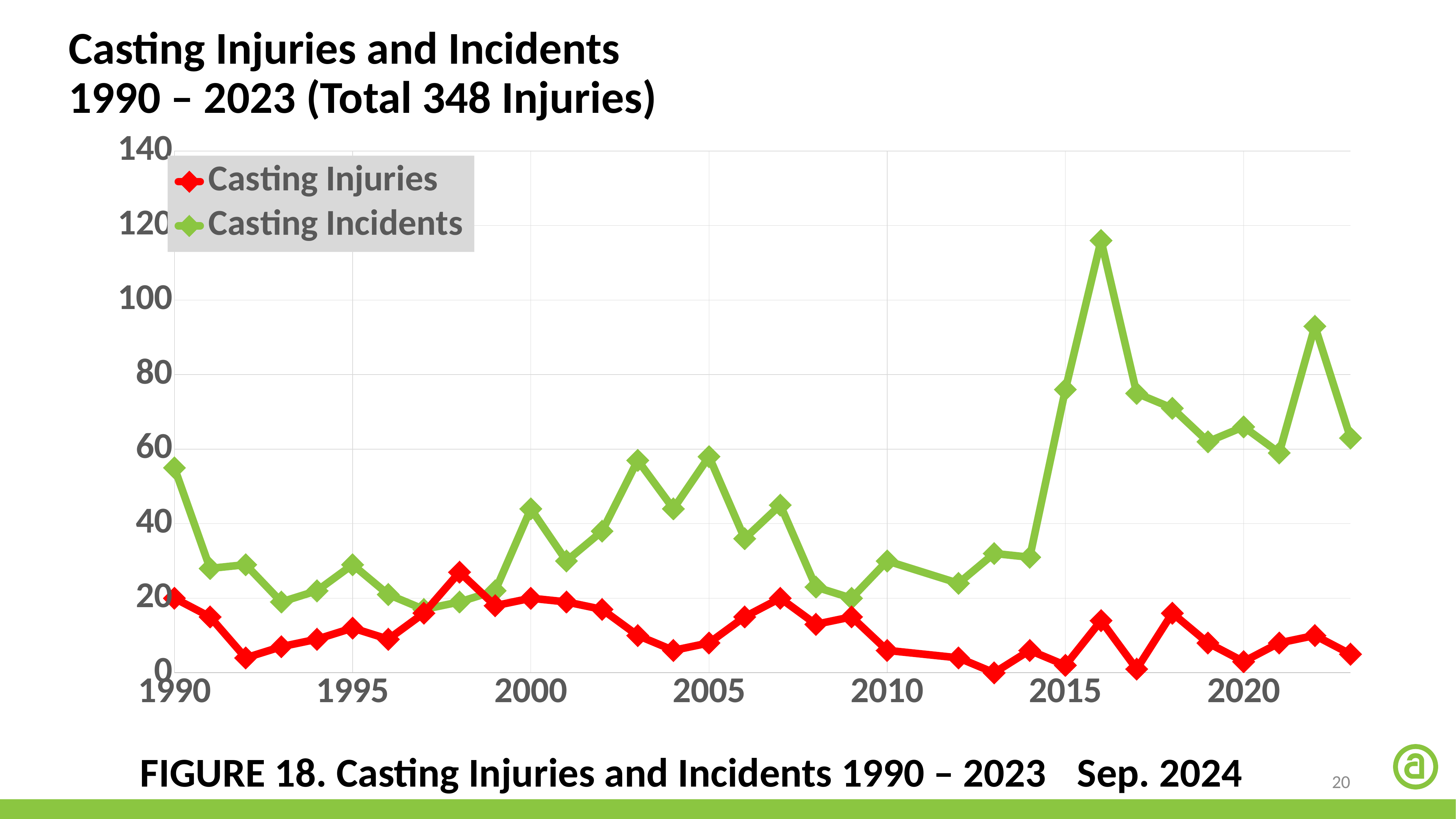
Which is larger, the Casting Incidents value in 2016 or in 2022? 2016 Is the value for Casting Injuries in 2016 greater or less than 20? less Which series is drawn in green? Casting Incidents Is the value for Casting Incidents in 1990 greater or less than 40? greater In which year does the Casting Injuries series reach its lowest value? 2013 Does the Casting Incidents series rise or fall between 2014 and 2016? Rise Is the value for Casting Incidents in 2022 greater or less than 80? greater What kind of chart is shown on the slide? Line chart How many series does the legend list? 2 What is the title of the chart? Casting Injuries and Incidents 1990 – 2023 (Total 348 Injuries) In which year does the Casting Incidents series reach its highest value? 2016